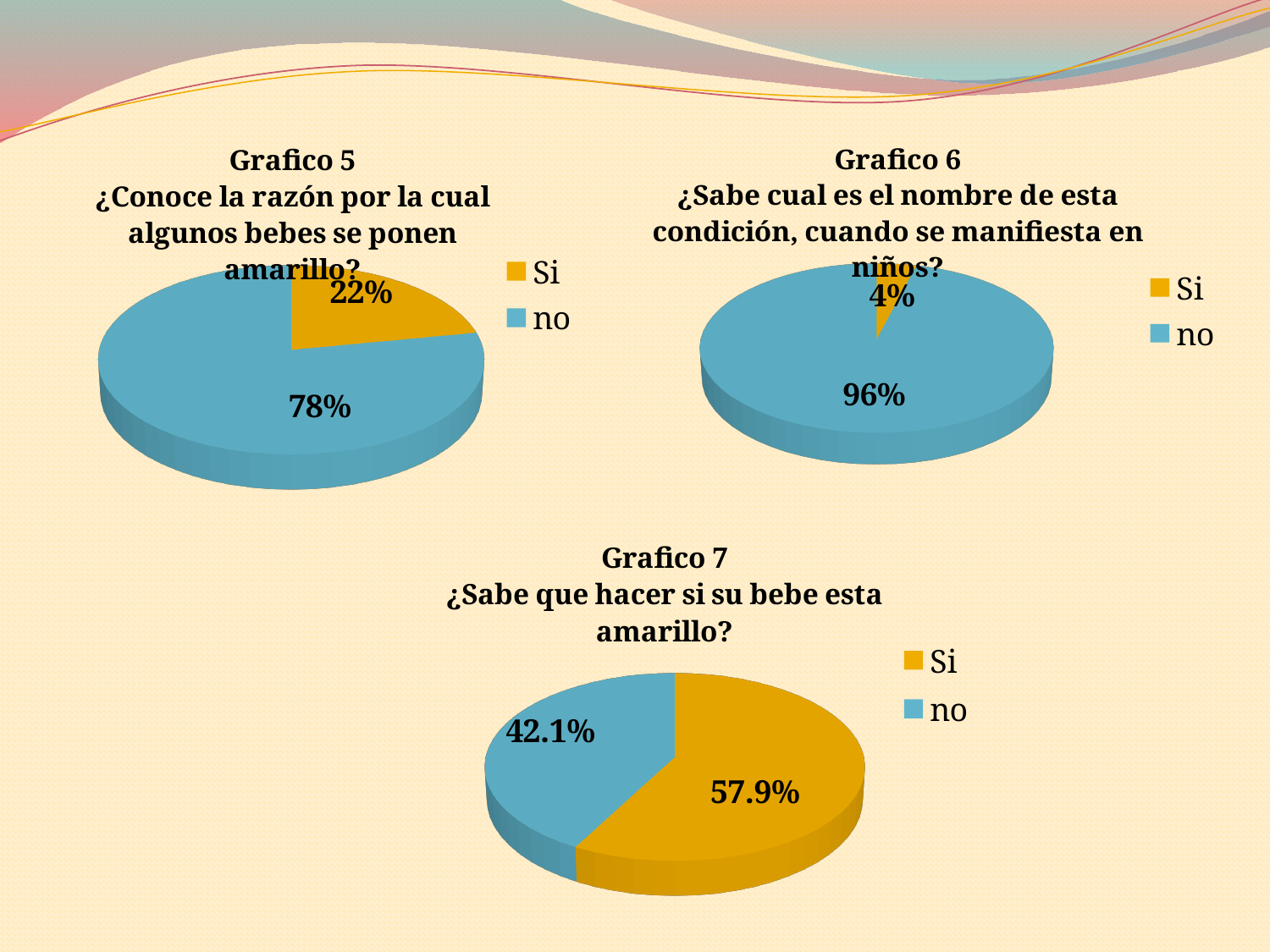
In Grafico 6, which answer has the smallest share? Si In Grafico 7, which answer has the larger share, 'Si' or 'no'? Si What kind of chart is Grafico 7? Pie chart In Grafico 5, what percentage of respondents answered 'no'? 78% In Grafico 6, what percentage of respondents answered 'no'? 96% In Grafico 5, what is the difference in percentage points between the 'no' and 'Si' shares? 56 How many entries does the legend of Grafico 6 list? 2 In Grafico 5, what percentage of respondents answered 'Si'? 22% In Grafico 7, what percentage of respondents answered 'Si'? 57.9% In Grafico 7, what is the difference in percentage points between the 'Si' and 'no' shares? 15.8 In Grafico 6, what percentage of respondents answered 'Si'? 4% In Grafico 7, what percentage of respondents answered 'no'? 42.1%